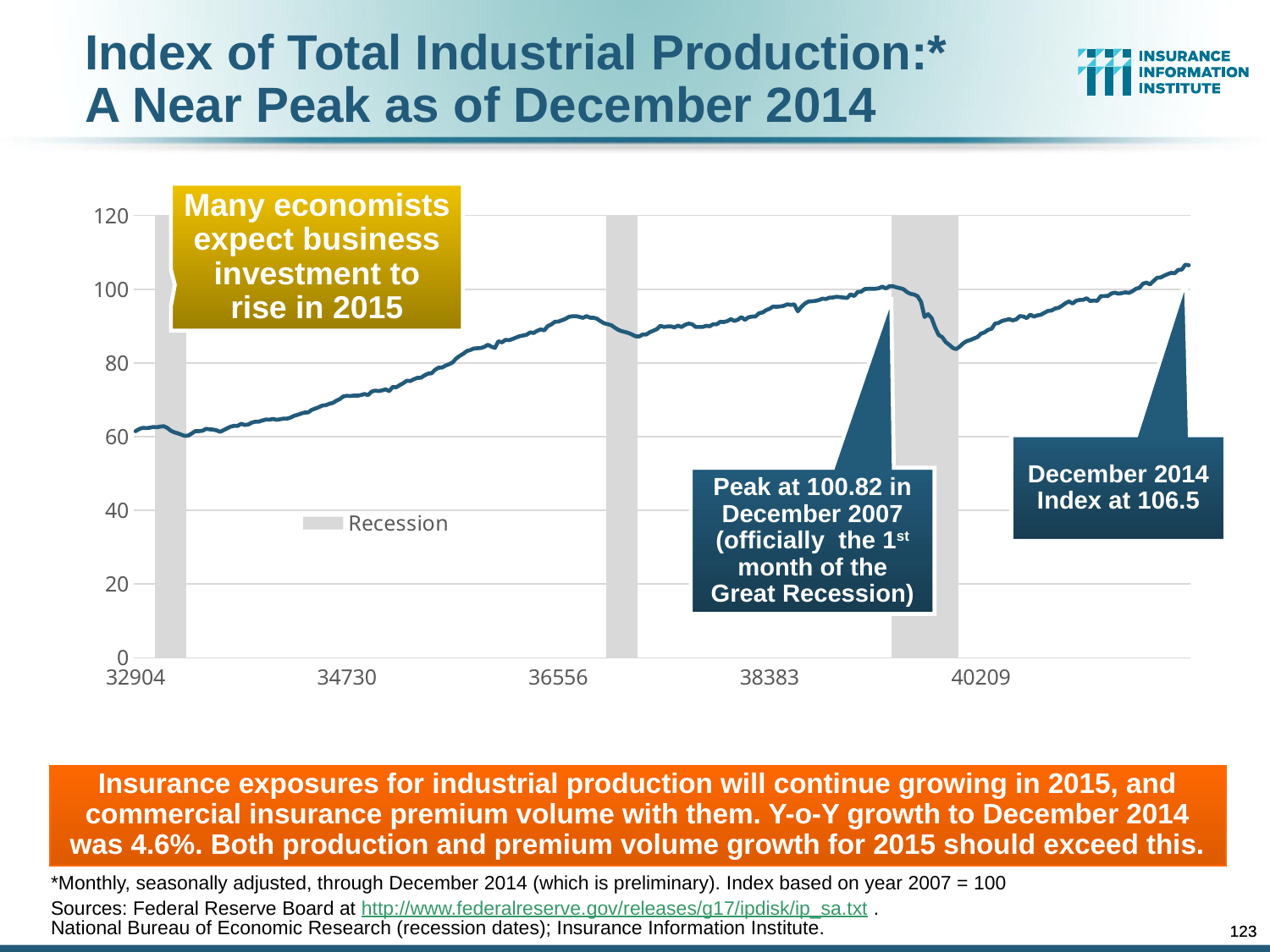
What is the value of the Index of Total Industrial Production in December 2014? 106.5 What kind of chart is shown on the slide? line chart Is the index value at the right end of the line greater or less than 100? greater Which month is labeled as officially the 1st month of the Great Recession? December 2007 By how much does the December 2014 index value exceed the December 2007 peak? 5.68 Which is higher, the index in December 2014 or the peak in December 2007? December 2014 What was the peak value of the index in December 2007? 100.82 What does the gray shading on the chart represent, according to the legend? Recession Over the whole period shown, does the index generally rise or fall? rise Is the index value at the left end of the line greater or less than 80? less How many gray shaded recession bands are shown on the chart? 3